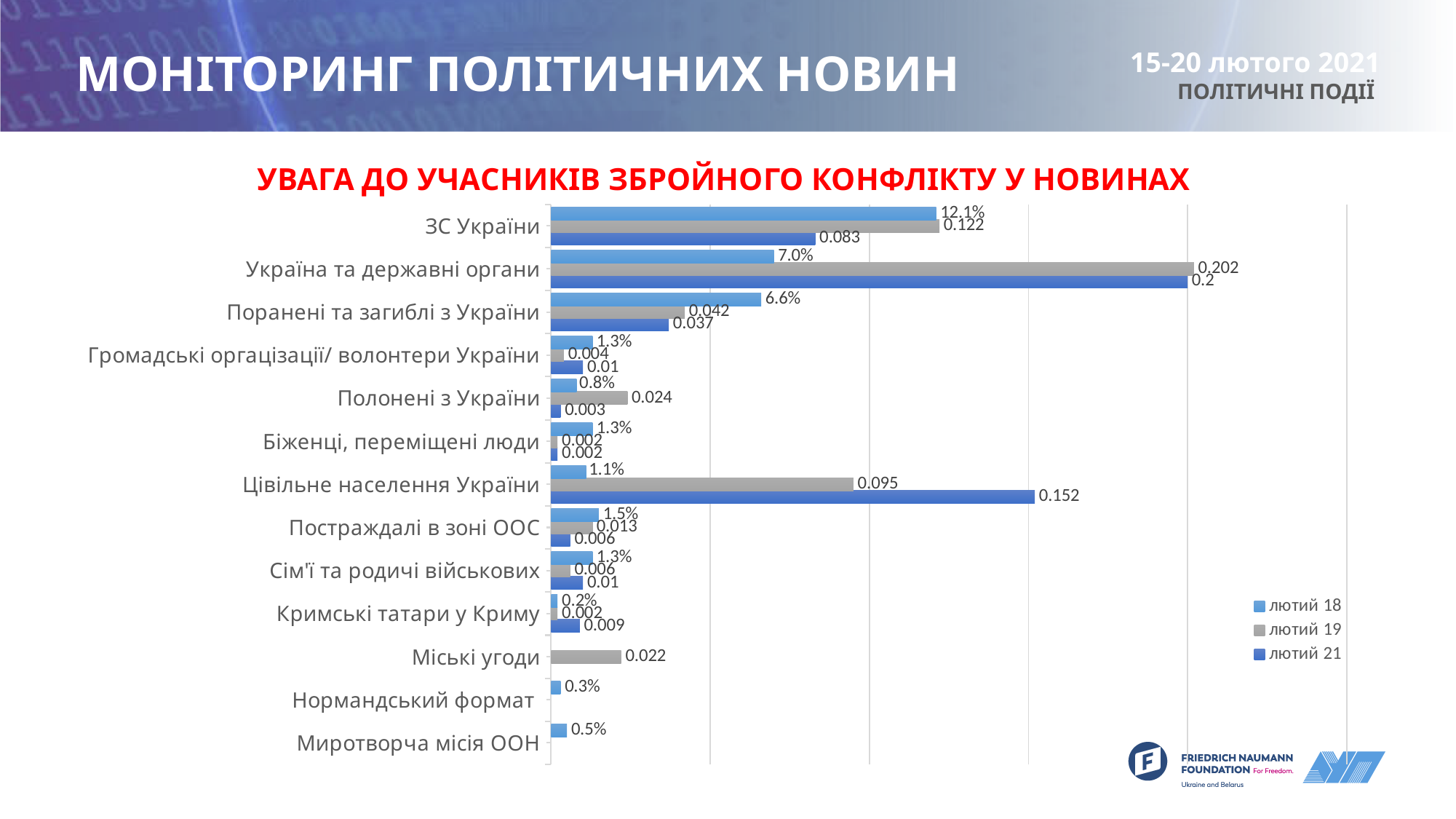
What is the value for ЗС України in the лютий 18 series? 12.1% What is the value for Україна та державні органи in the лютий 19 series? 0.202 What is the difference between the лютий 19 and лютий 21 values for Полонені з України? 0.021 What are the three series listed in the legend? лютий 18, лютий 19, лютий 21 Which category has the highest value in the лютий 21 series? Україна та державні органи How many series does the legend list? 3 What is the value for Міські угоди in the лютий 19 series? 0.022 For Цівільне населення України, which is larger: the лютий 19 value or the лютий 21 value? лютий 21 What is the value for Цівільне населення України in the лютий 21 series? 0.152 Which category has the highest value in the лютий 18 series? ЗС України How many categories are shown on the chart? 13 What kind of chart is shown on the slide? Bar chart